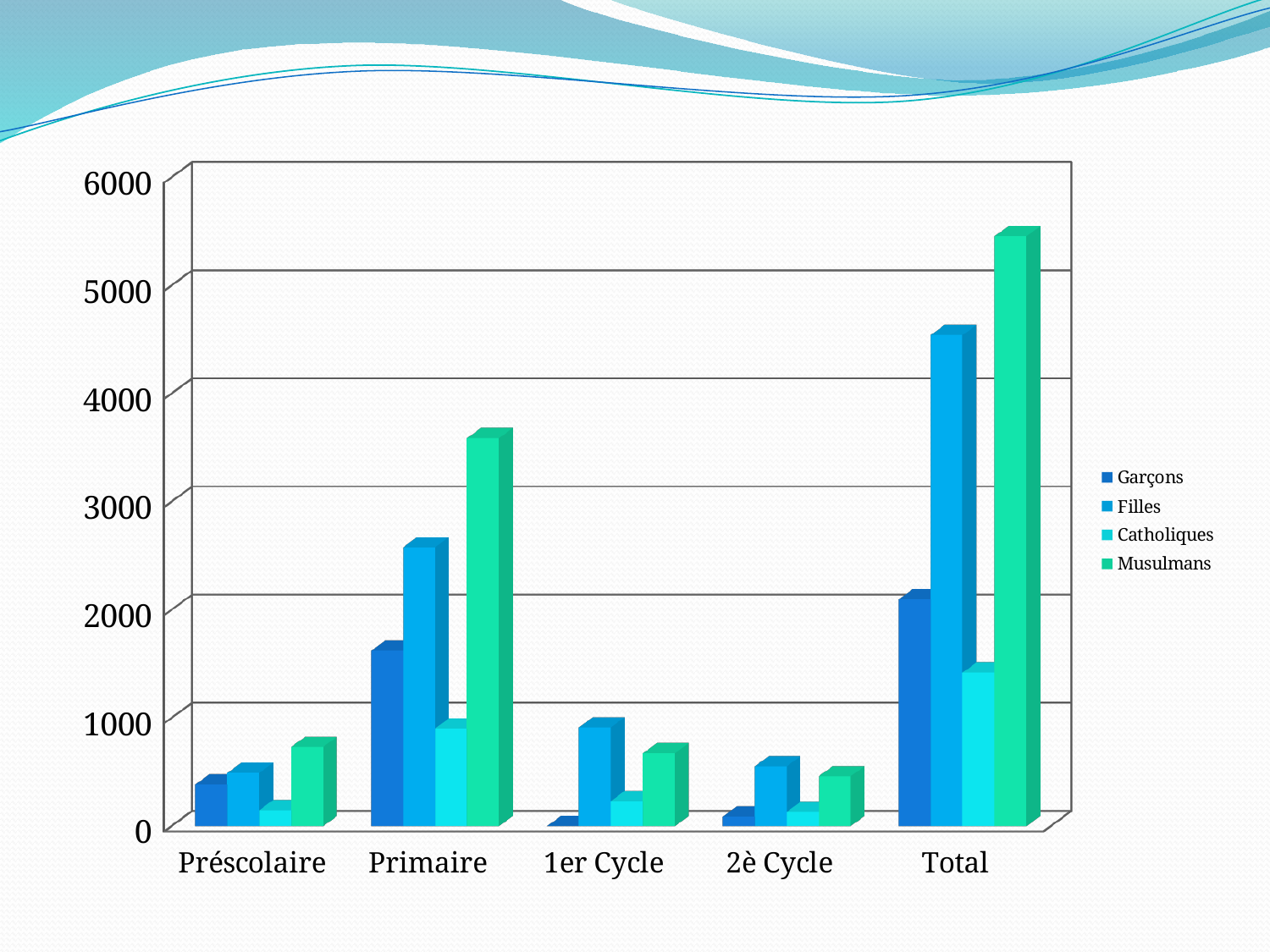
Which series has the lowest value in the 1er Cycle category? Garçons Is the value for Garçons in the Primaire category greater or less than 2000? less What kind of chart is shown on the slide? bar chart Is the value for Musulmans in the Primaire category greater or less than 3000? greater Which series has the highest value in the Primaire category? Musulmans How many series does the legend list? 4 In the 1er Cycle category, which is larger: the value for Filles or the value for Musulmans? Filles How many categories are shown along the x axis? 5 Which series is listed last in the legend? Musulmans Is the value for Catholiques in the Total category greater or less than 1000? greater